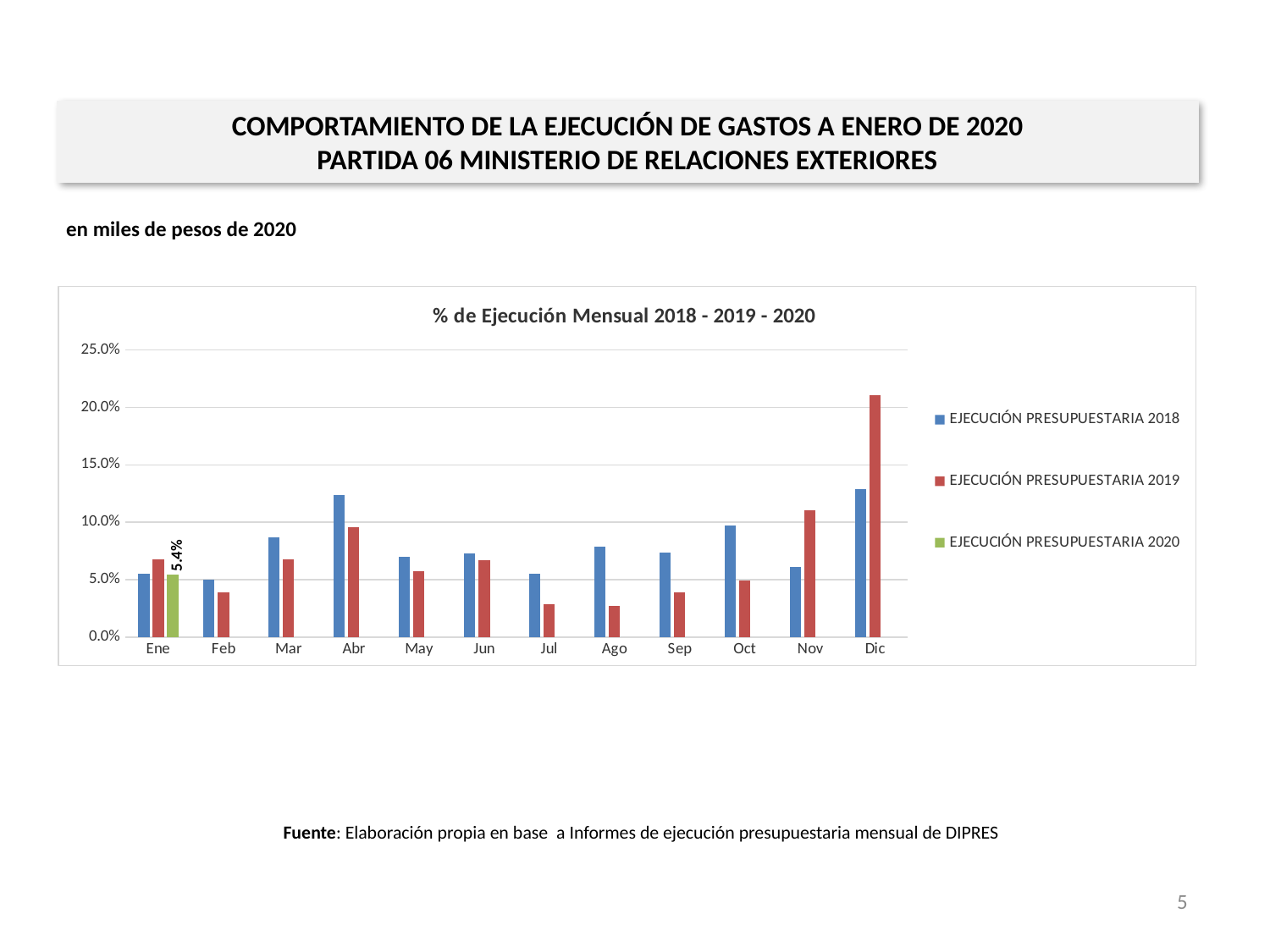
In which month is EJECUCIÓN PRESUPUESTARIA 2019 highest? Dic How many series does the legend list? 3 Is the value for EJECUCIÓN PRESUPUESTARIA 2018 in Abr greater or less than 10.0%? greater In Ago, which series has the larger value, EJECUCIÓN PRESUPUESTARIA 2018 or EJECUCIÓN PRESUPUESTARIA 2019? EJECUCIÓN PRESUPUESTARIA 2018 Is the value for EJECUCIÓN PRESUPUESTARIA 2019 in Dic greater or less than 20.0%? greater What is the value of EJECUCIÓN PRESUPUESTARIA 2020 for Ene? 5.4% What kind of chart is shown on the slide? Bar chart In Nov, which series has the larger value, EJECUCIÓN PRESUPUESTARIA 2018 or EJECUCIÓN PRESUPUESTARIA 2019? EJECUCIÓN PRESUPUESTARIA 2019 What colour are the bars for EJECUCIÓN PRESUPUESTARIA 2020? Green What is the title of the chart? % de Ejecución Mensual 2018 - 2019 - 2020 Is the value for EJECUCIÓN PRESUPUESTARIA 2019 in Jul greater or less than 5.0%? less How many months are shown on the x axis? 12